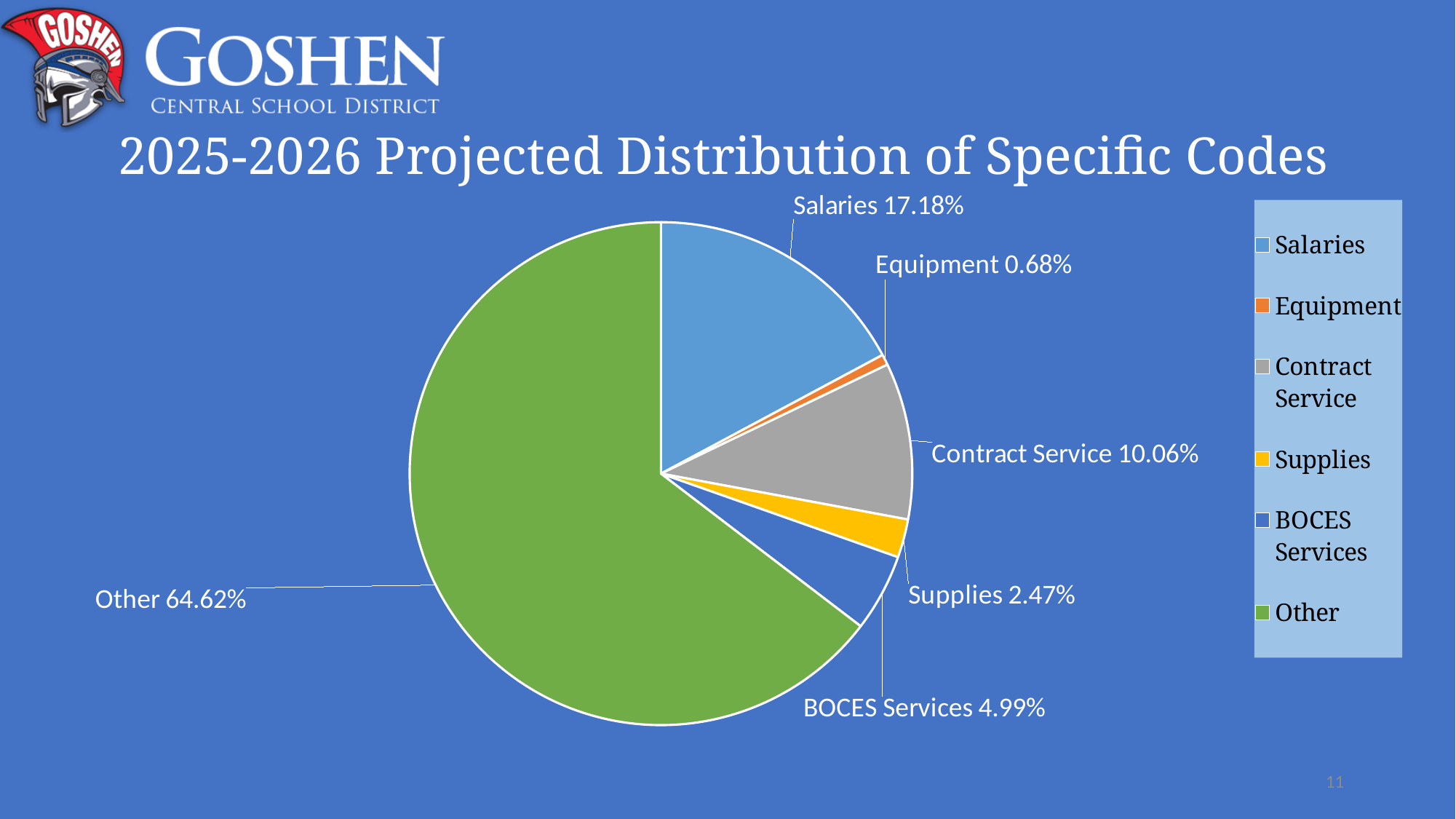
What is the difference between the Salaries share and the Contract Service share? 7.12% What percentage is shown for BOCES Services? 4.99% What is the value shown for Contract Service? 10.06% What is the value shown for Equipment? 0.68% Which category has the largest slice of the pie? Other Which is larger, Supplies or BOCES Services? BOCES Services What colour is the Supplies slice in the pie chart? Yellow How many categories are shown in the pie chart? 6 What share of the pie does Salaries represent? 17.18% What is the title of the slide's chart? 2025-2026 Projected Distribution of Specific Codes What kind of chart is shown on the slide? Pie chart Which category has the smallest slice of the pie? Equipment